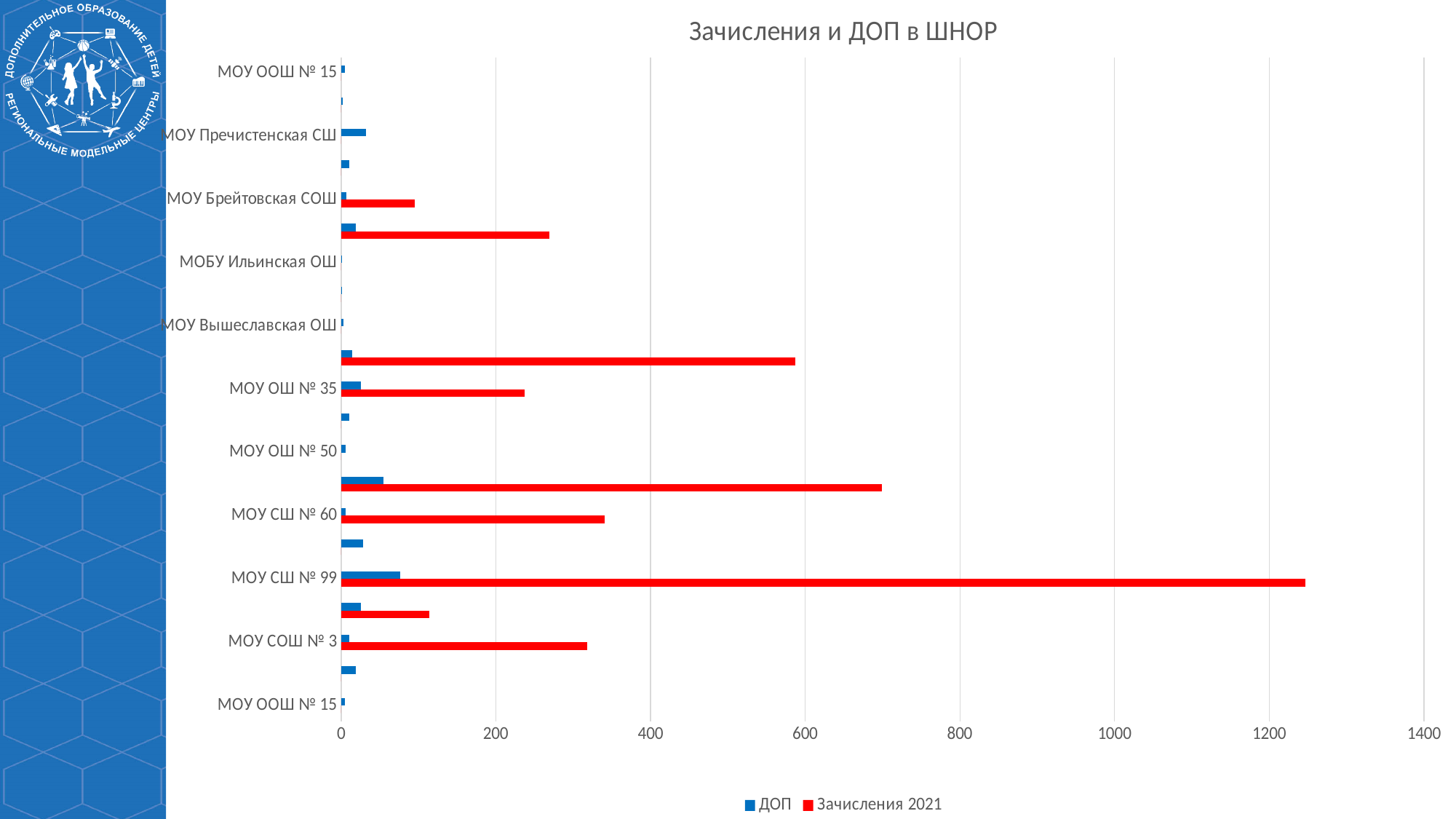
Is the Зачисления 2021 value for МОУ СШ № 60 greater or less than 400? less Is the ДОП value for МОУ СШ № 99 greater or less than 200? less Is the Зачисления 2021 value for МОУ Брейтовская СОШ greater or less than 200? less Which labeled school has the highest value for Зачисления 2021? МОУ СШ № 99 What kind of chart is shown on the slide? bar chart Which has the larger Зачисления 2021 value, МОУ СОШ № 3 or МОУ Брейтовская СОШ? МОУ СОШ № 3 Which colour represents the series Зачисления 2021 in the chart? red What is the title of the chart? Зачисления и ДОП в ШНОР How many series does the legend list? 2 Which has the larger Зачисления 2021 value, МОУ СШ № 99 or МОУ СШ № 60? МОУ СШ № 99